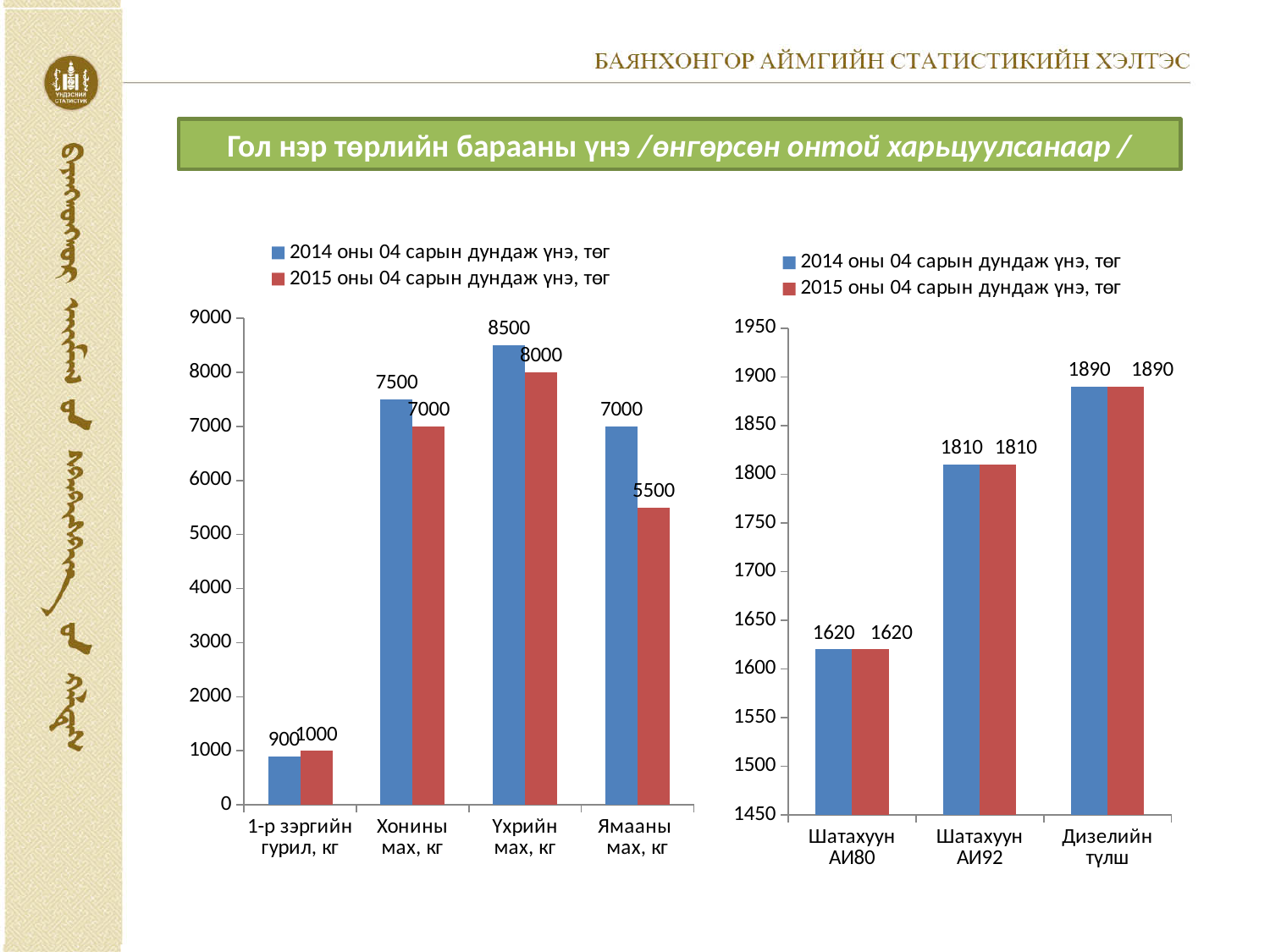
On the right chart, which category has the highest value? Дизелийн түлш On the right chart, how many series does the legend list? 2 On the left chart, what is the 2015 оны 04 сарын дундаж үнэ for Ямааны мах, кг? 5500 On the right chart, what is the difference between the 2014 and 2015 values for Дизелийн түлш? 0 On the left chart, which category has the lowest 2015 оны 04 сарын дундаж үнэ? 1-р зэргийн гурил, кг On the left chart, what is the 2014 оны 04 сарын дундаж үнэ for Үхрийн мах, кг? 8500 On the right chart, what is the 2015 оны 04 сарын дундаж үнэ for Шатахуун АИ92? 1810 What type of chart is the right chart? Bar chart On the left chart, what is the difference between the 2014 and 2015 values for Ямааны мах, кг? 1500 On the left chart, how many categories are shown on the x axis? 4 On the left chart, which is larger for 1-р зэргийн гурил, кг: the 2014 value or the 2015 value? 2015 value On the left chart, which category has the highest 2014 оны 04 сарын дундаж үнэ? Үхрийн мах, кг